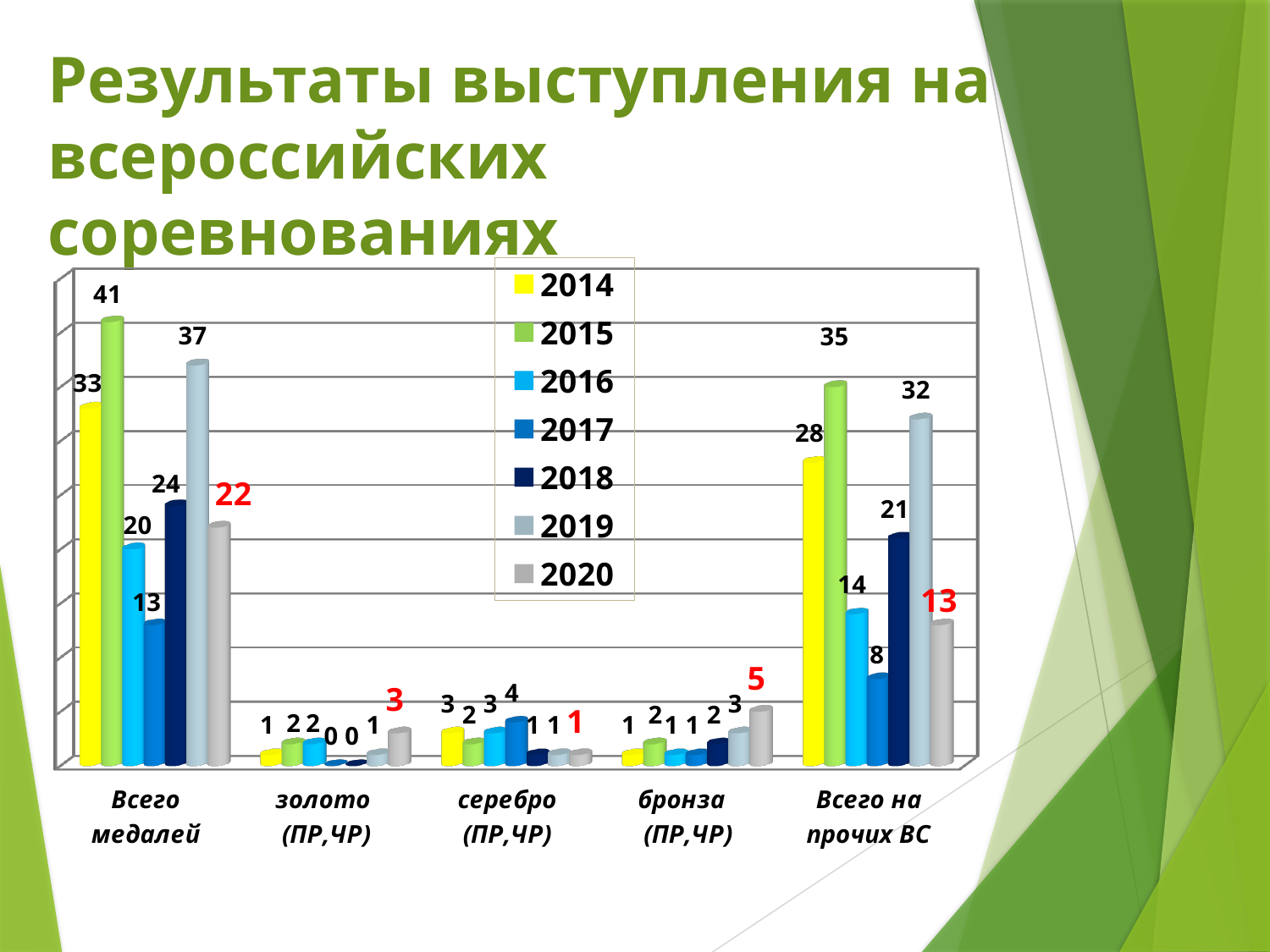
Which colour represents the 2014 series in the legend? yellow What is the value for 2020 in the "Всего на прочих ВС" category? 13 Which year has the highest value in the "Всего медалей" category? 2015 How many series does the legend list? 7 How many categories are shown on the x axis? 5 What is the value for 2015 in the "Всего медалей" category? 41 What kind of chart is shown on the slide? bar chart Which year has the lowest value in the "Всего на прочих ВС" category? 2017 What is the difference between the 2019 and 2020 values in the "Всего медалей" category? 15 In the "бронза (ПР,ЧР)" category, which is larger: the value for 2019 or the value for 2020? 2020 What is the value for 2020 in the "золото (ПР,ЧР)" category? 3 What is the value for 2017 in the "серебро (ПР,ЧР)" category? 4